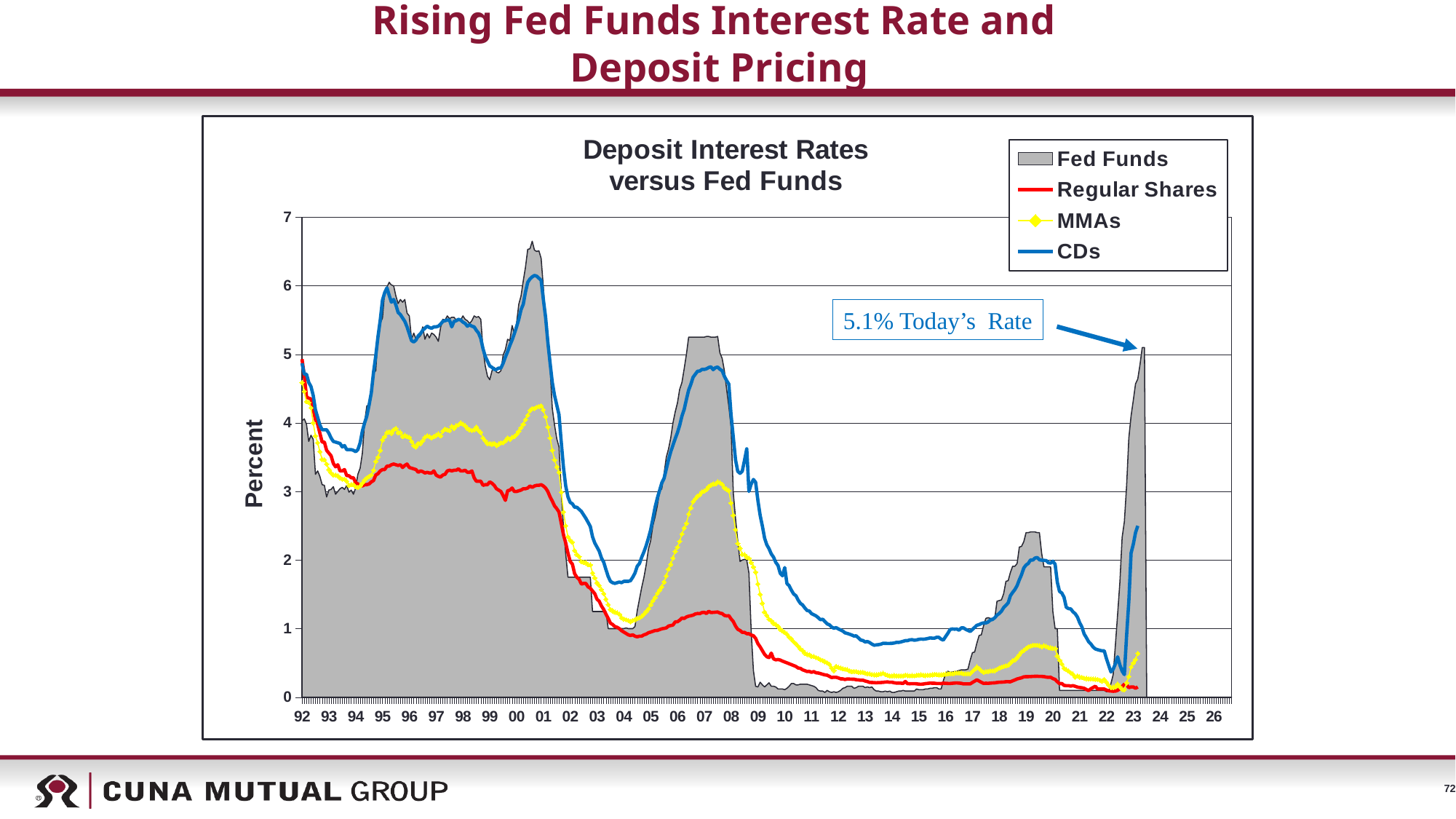
Is the value for CDs in 2007 greater or less than 4? greater Is the value for Regular Shares in 2014 greater or less than 1? less What is the title of the chart on the slide? Deposit Interest Rates versus Fed Funds Which series is shown as a shaded gray area in the chart? Fed Funds How many series does the legend list in the Deposit Interest Rates versus Fed Funds chart? 4 In 2007, which is larger: MMAs or Regular Shares? MMAs Do Fed Funds rise or fall between 2007 and 2009? fall Do CDs rise or fall between 2022 and 2023? rise According to the annotation on the chart, what is today's Fed Funds rate? 5.1% Is the value for MMAs in 2013 greater or less than 1? less What is the label on the vertical axis of the chart? Percent In 2019, which is larger: CDs or Regular Shares? CDs